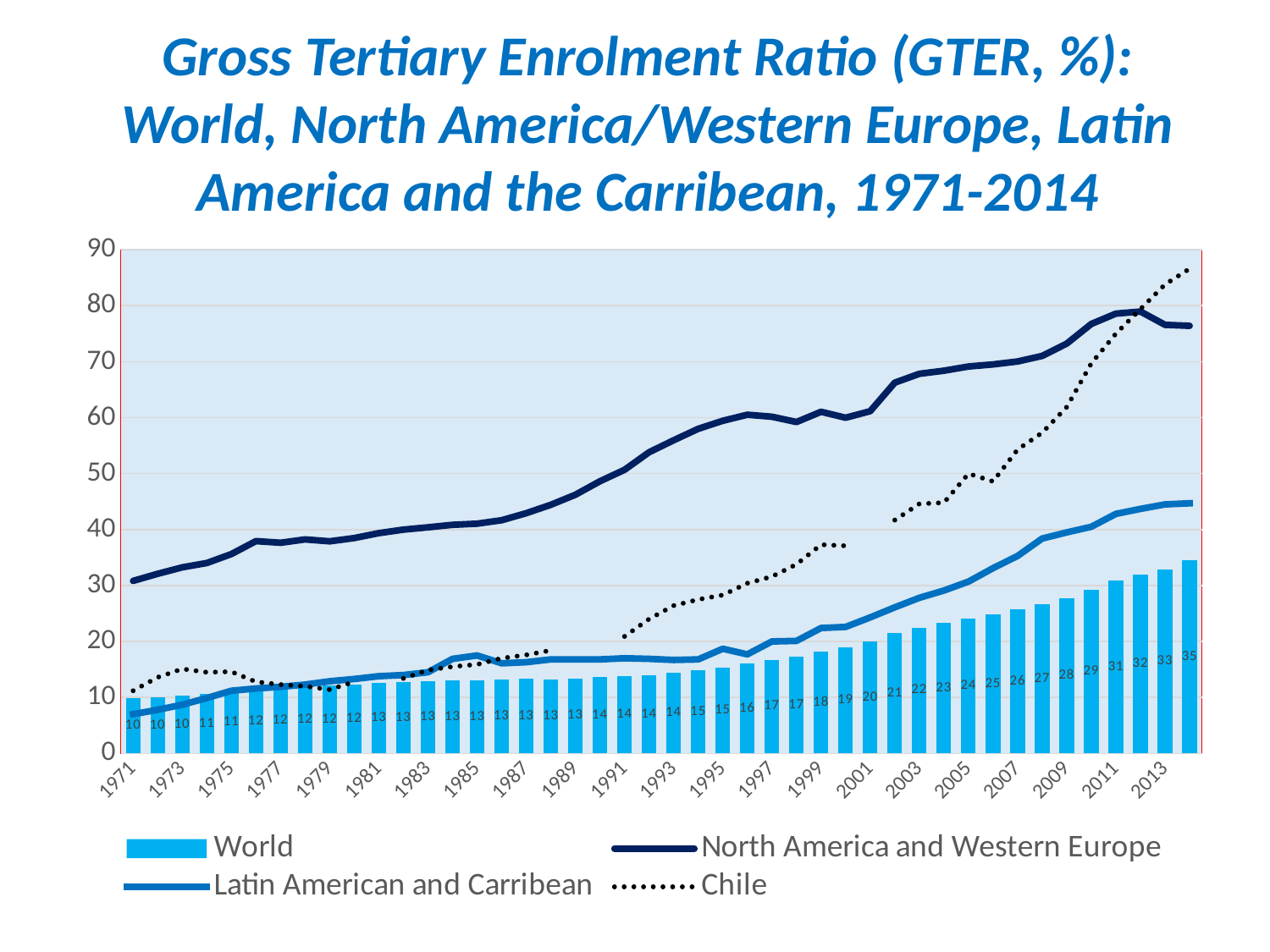
In 1991, which is larger: North America and Western Europe or Latin American and Carribean? North America and Western Europe What is the World value for 2009? 28 What is the World value for 2001? 20 Do the World values rise or fall from 1971 to 2014? Rise What is the difference between the World values for 2013 and 1971? 23 Which series is drawn with a dotted line? Chile What is the World value for 1971? 10 Is the value for North America and Western Europe in 2013 greater or less than 70? greater In which year is the World value highest? 2014 How many series does the legend list? 4 What kind of chart is this? Combined bar and line chart What is the World value for 2014? 35